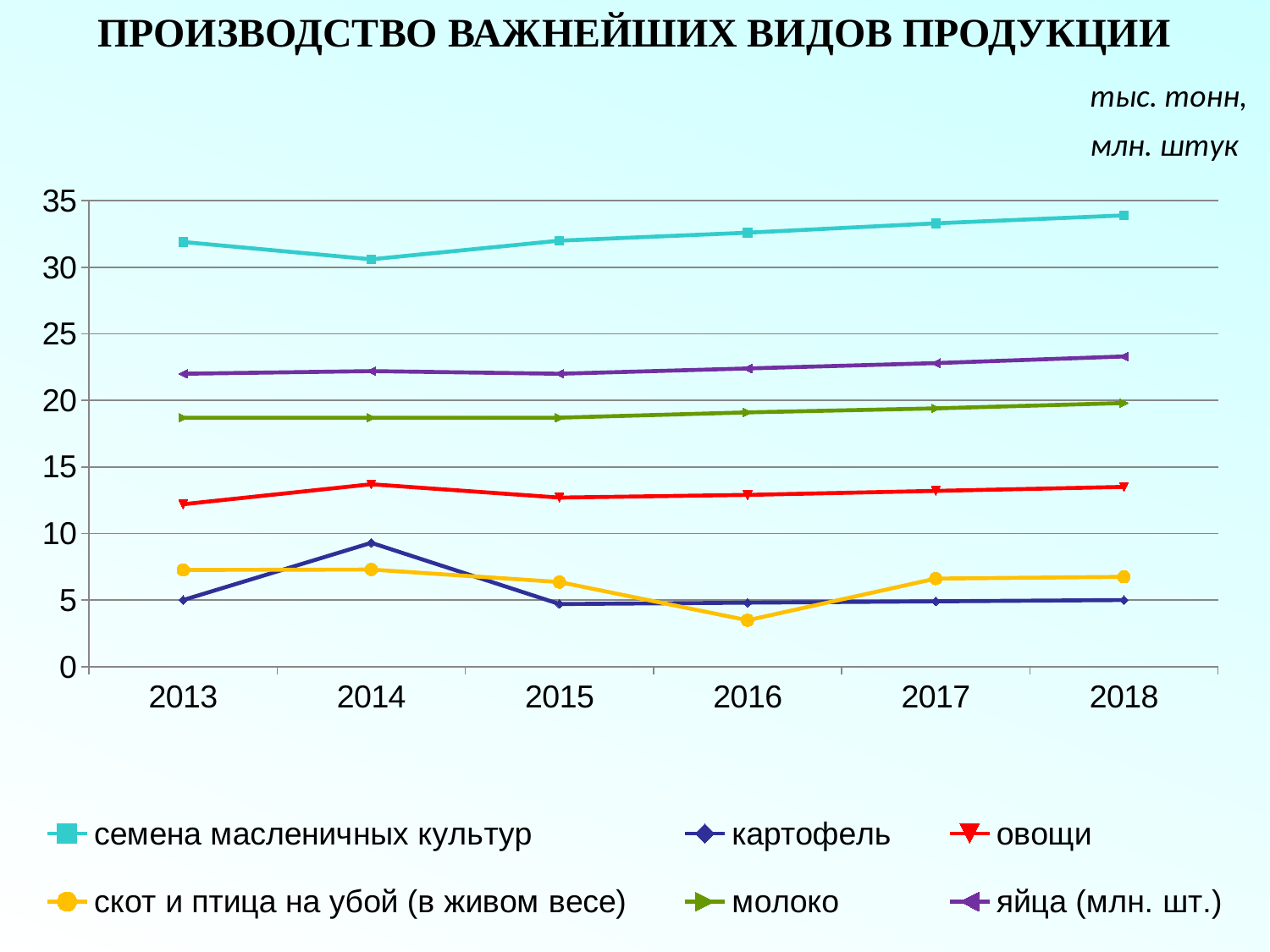
In which year is the value for скот и птица на убой (в живом весе) lowest? 2016 How many series does the legend list? 6 In 2014, which is larger: картофель or скот и птица на убой (в живом весе)? картофель Which series has the lowest value in 2016? скот и птица на убой (в живом весе) Does the value for молоко rise or fall from 2013 to 2018? rise How many years are shown on the x axis? 6 In which year is the value for картофель highest? 2014 Is the value for картофель in 2014 greater or less than 5? greater Is the value for семена масленичных культур in 2018 greater or less than 30? greater Which series has the highest value in 2018? семена масленичных культур What kind of chart is shown on the slide? line chart Is the value for скот и птица на убой (в живом весе) in 2016 greater or less than 5? less